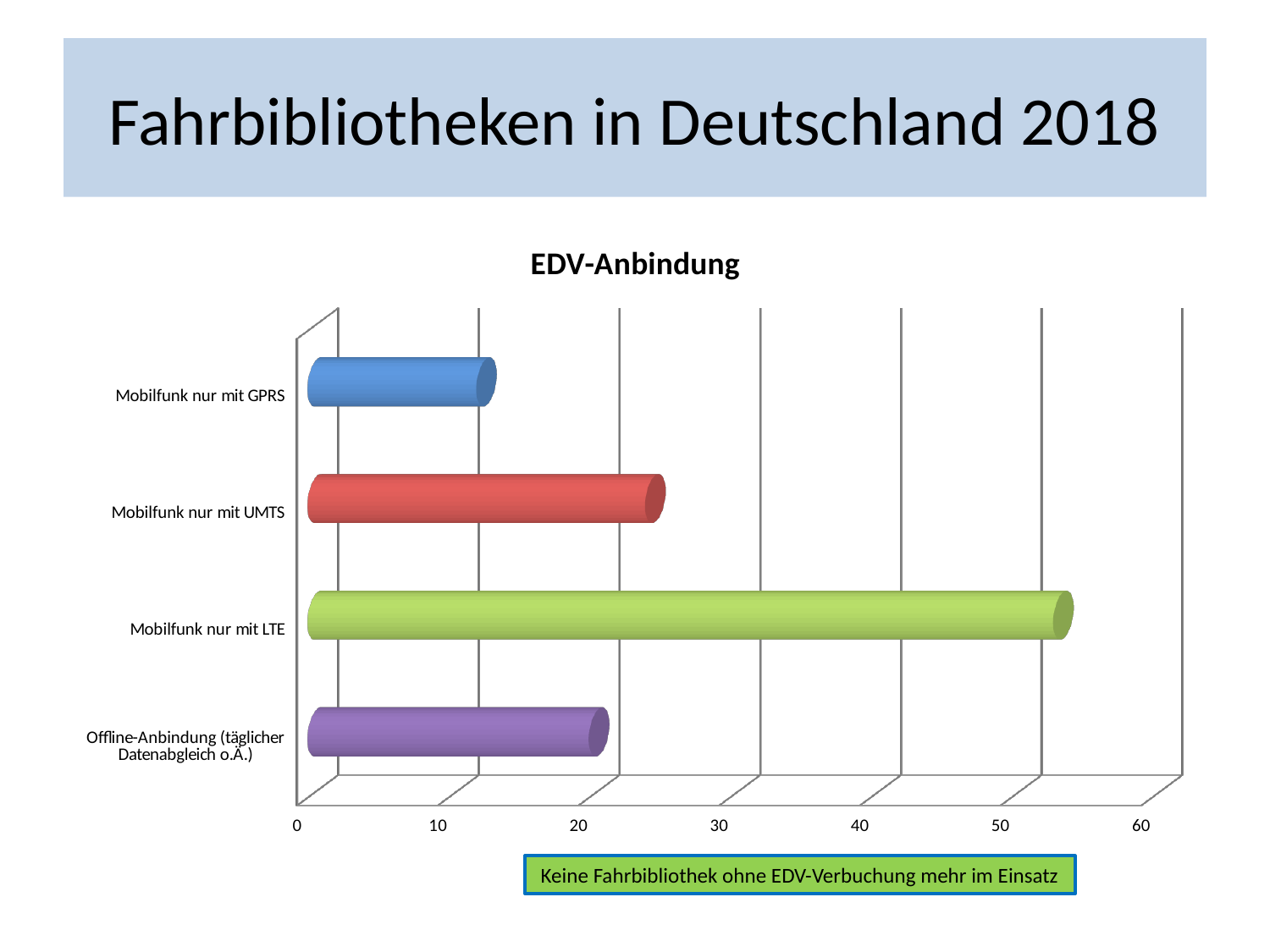
Is the value for Offline-Anbindung (täglicher Datenabgleich o.Ä.) greater or less than 30? less Which category has the highest value in the EDV-Anbindung chart? Mobilfunk nur mit LTE Is the value for Mobilfunk nur mit GPRS greater or less than 20? less How many categories are plotted in the EDV-Anbindung chart? 4 Is the value for Mobilfunk nur mit UMTS greater or less than 20? greater What is the title of the chart on the slide? EDV-Anbindung Which is larger, the value for Mobilfunk nur mit LTE or for Offline-Anbindung (täglicher Datenabgleich o.Ä.)? Mobilfunk nur mit LTE Which category has the lowest value in the EDV-Anbindung chart? Mobilfunk nur mit GPRS Which is larger, the value for Mobilfunk nur mit UMTS or for Mobilfunk nur mit GPRS? Mobilfunk nur mit UMTS What is the highest value shown on the horizontal axis of the EDV-Anbindung chart? 60 What kind of chart is shown under the title "EDV-Anbindung"? bar chart